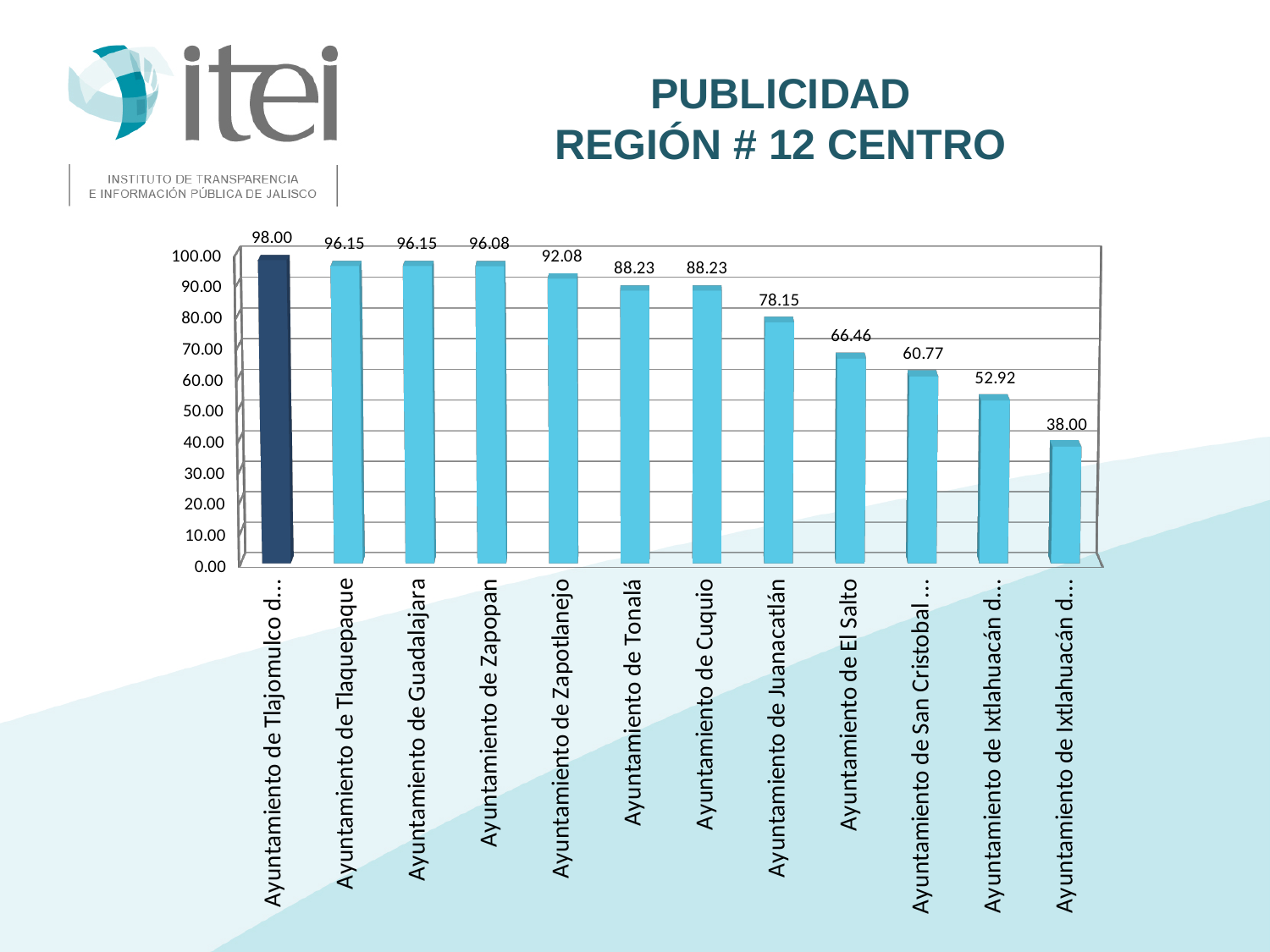
What is the value for Ayuntamiento de San Cristobal? 60.77 What is the value for Ayuntamiento de Zapotlanejo? 92.08 Which is larger, the value for Ayuntamiento de Cuquio or Ayuntamiento de El Salto? Ayuntamiento de Cuquio Do the values rise or fall from left to right across the chart? Fall What is the difference between the values for Ayuntamiento de Tonalá and Ayuntamiento de Juanacatlán? 10.08 What is the value for Ayuntamiento de Guadalajara? 96.15 What is the lowest value shown in the chart? 38.00 How many bars are shown in the chart? 12 What is the value for Ayuntamiento de El Salto? 66.46 What is the value for Ayuntamiento de Juanacatlán? 78.15 What kind of chart is shown on the slide? Bar chart Which category has the highest value? Ayuntamiento de Tlajomulco